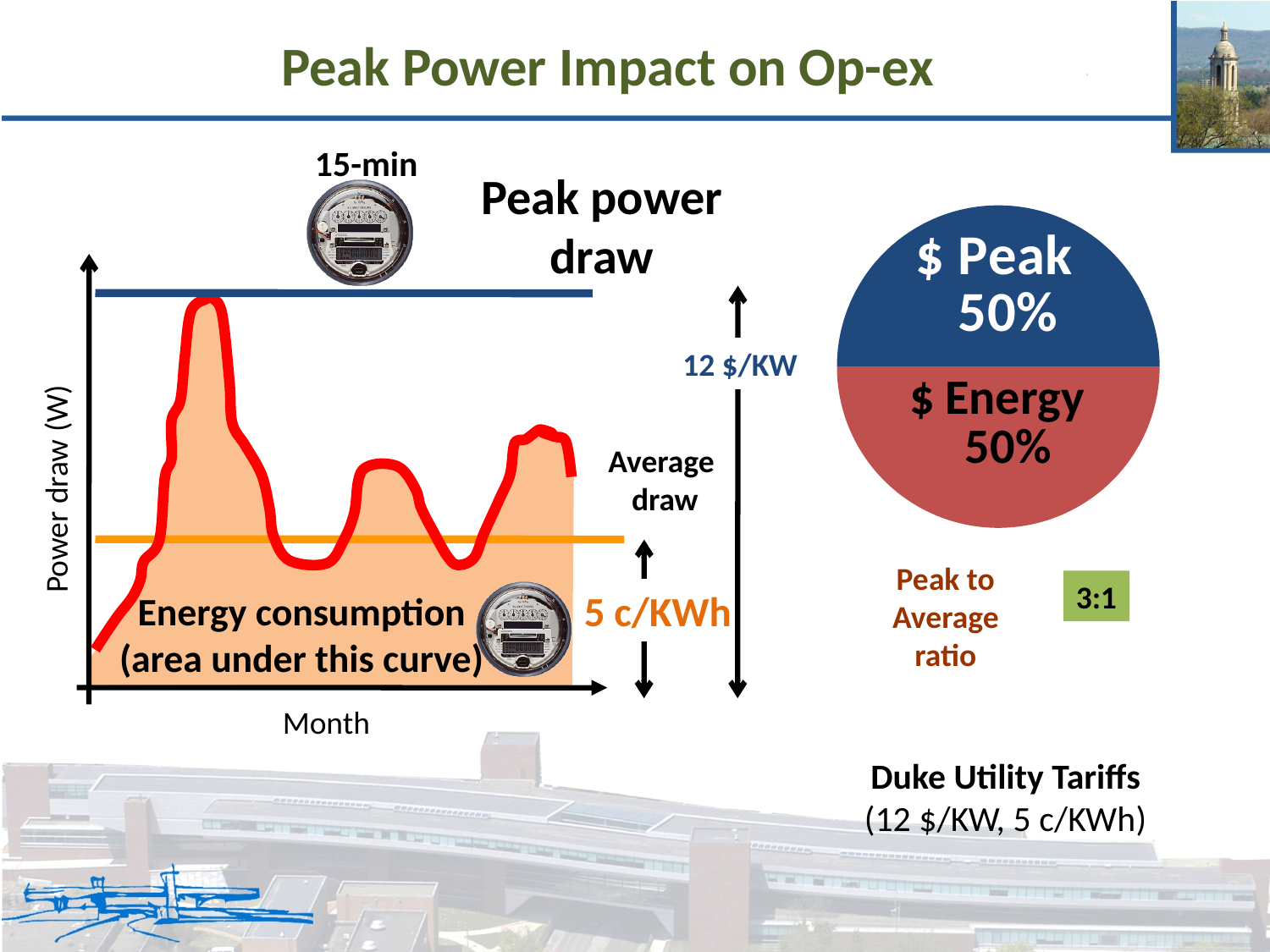
On the pie chart, what share of the cost is labelled "$ Peak"? 50% What is the label on the x axis of the power draw chart on the left? Month What colour is the "$ Peak" slice of the pie chart? Blue What tariff is shown next to the peak power draw arrow on the left chart? 12 $/KW On the left chart, is the peak power draw line above or below the average draw line? Above What peak-to-average ratio is stated on the slide? 3:1 What is the label on the y axis of the chart on the left? Power draw (W) What kind of chart is shown on the right side of the slide? Pie chart What tariff is shown next to the average draw arrow on the left chart? 5 c/KWh On the pie chart, what share of the cost is labelled "$ Energy"? 50% How many slices does the pie chart on the right have? 2 On the pie chart, is the "$ Peak" slice larger or smaller than the "$ Energy" slice, or are they equal? Equal